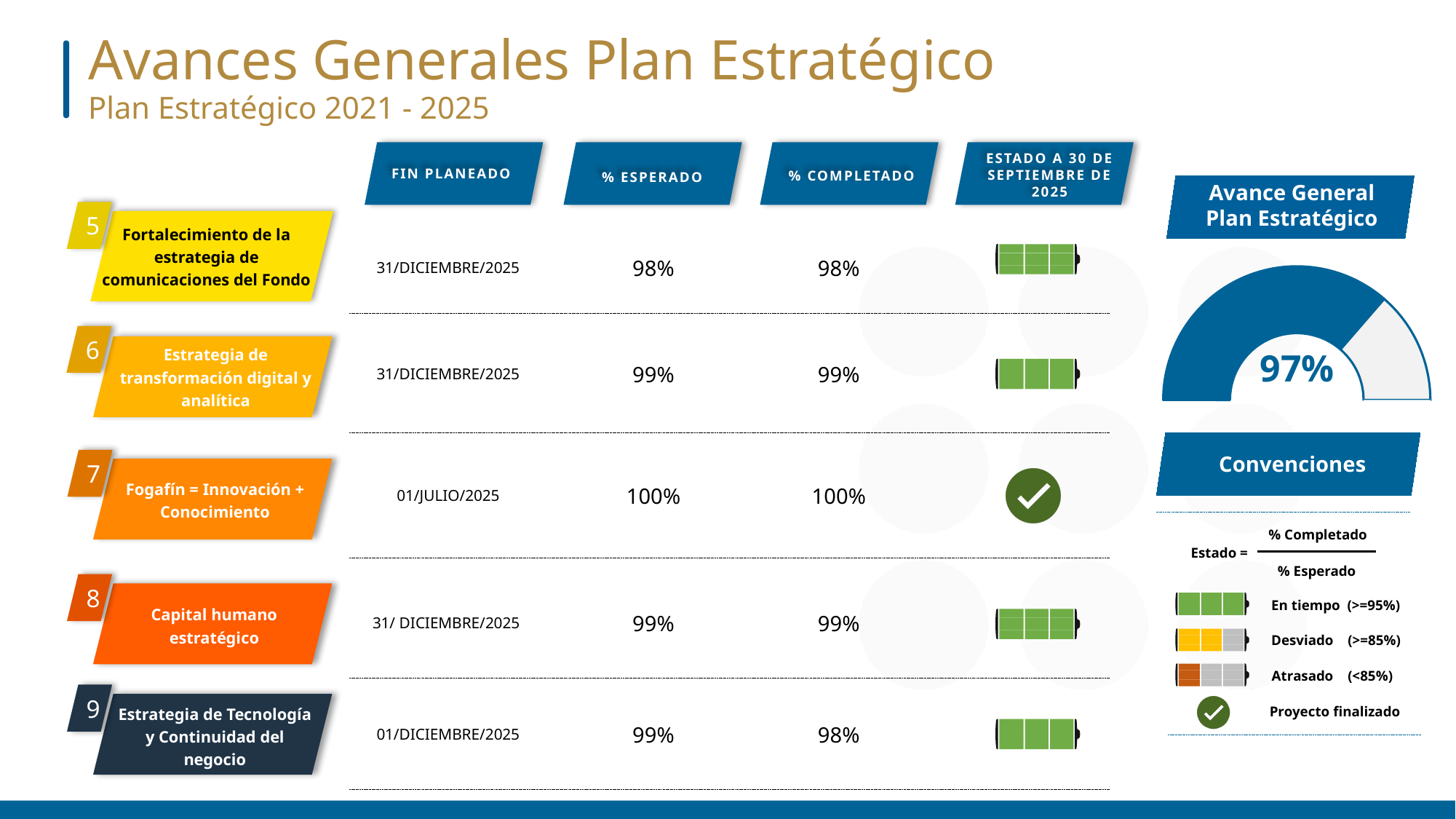
What kind of chart is used to show the 'Avance General Plan Estratégico'? gauge chart What is the title of the gauge chart on the right side of the slide? Avance General Plan Estratégico What value does the 'Avance General Plan Estratégico' gauge chart show? 97% How many values are plotted on the 'Avance General Plan Estratégico' gauge chart? 1 What colour is the filled portion of the 'Avance General Plan Estratégico' gauge? blue Is the value shown on the 'Avance General Plan Estratégico' gauge greater or less than 90%? greater